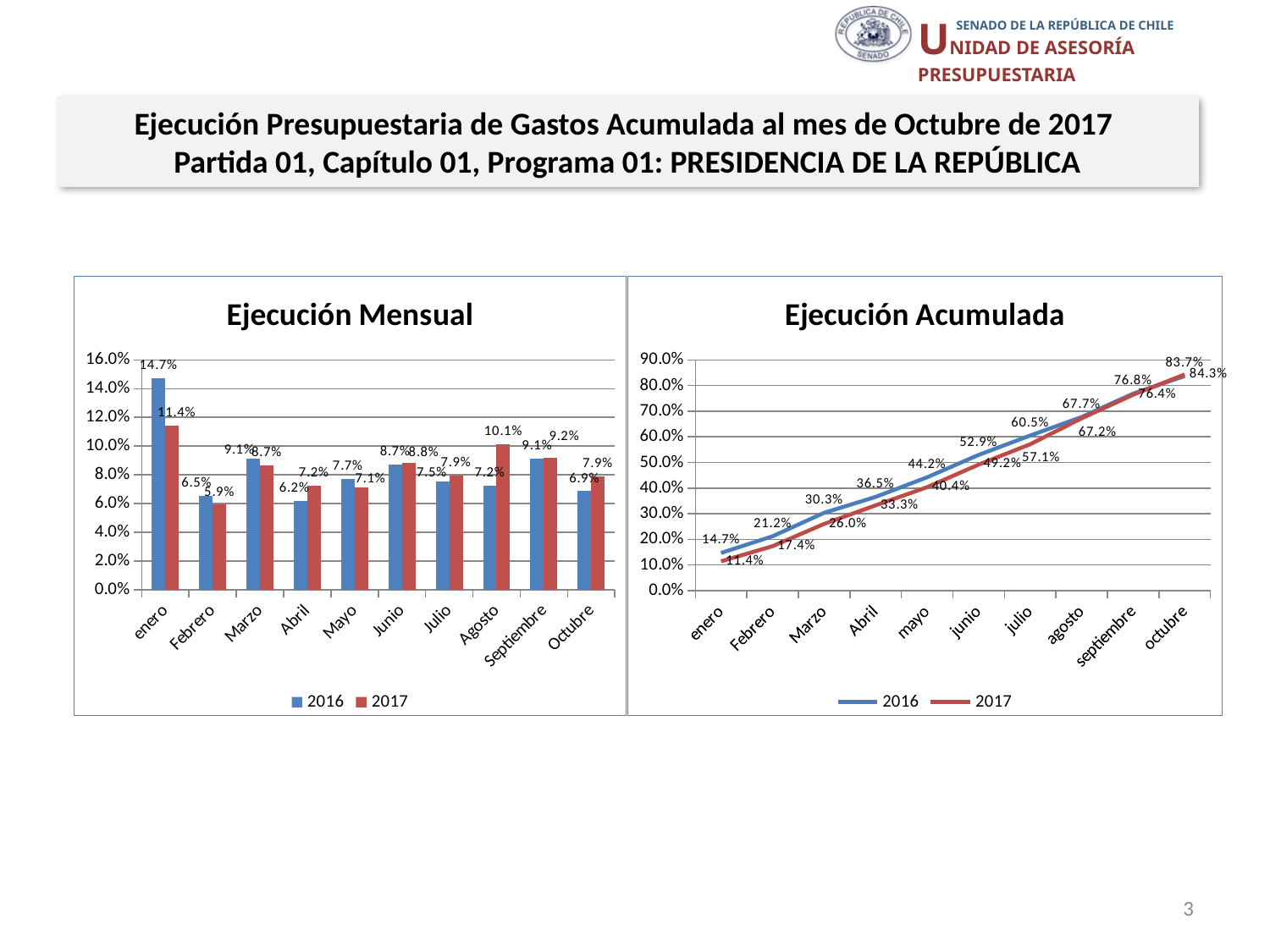
In the 'Ejecución Acumulada' chart, do the values for 2016 rise or fall from enero to octubre? Rise In the 'Ejecución Mensual' chart, which is larger in Abril: the 2016 value or the 2017 value? 2017 How many months are shown on the x axis of the 'Ejecución Acumulada' chart? 10 How many series does the legend of the 'Ejecución Acumulada' chart list? 2 In the 'Ejecución Mensual' chart, what is the value for 2017 in Agosto? 10.1% In the 'Ejecución Mensual' chart, what is the difference between the 2017 and 2016 values in Agosto? 2.9% In the 'Ejecución Acumulada' chart, what is the value for 2017 in octubre? 84.3% What kind of chart is 'Ejecución Mensual'? Bar chart In the 'Ejecución Mensual' chart, which month has the highest value for the 2016 series? enero In the 'Ejecución Acumulada' chart, what is the difference between the 2016 and 2017 values in junio? 3.7% In the 'Ejecución Mensual' chart, which month has the lowest value for the 2017 series? Febrero In the 'Ejecución Mensual' chart, what is the value for 2016 in enero? 14.7%